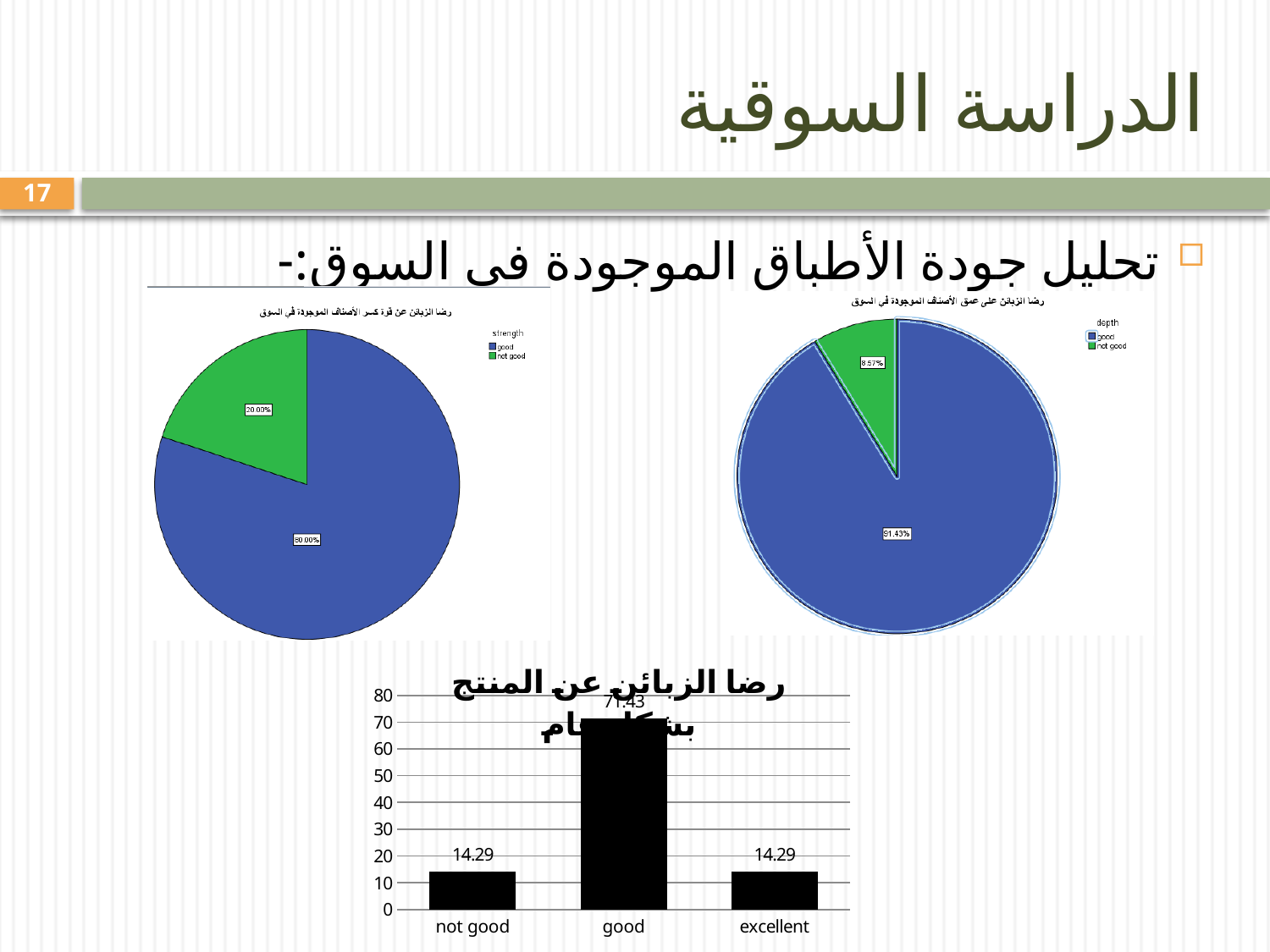
In the bottom bar chart, what is the value for "not good"? 14.29 In the top-left pie chart (legend titled "strength"), what share does the "not good" slice have? 20.00% How many entries does the legend of the top-right pie chart list? 2 In the top-left pie chart (legend titled "strength"), what share does the "good" slice have? 80.00% In the bottom bar chart, is the value for "good" greater or less than 70? greater What kind of chart is the bottom chart on the slide? bar chart In the top-right pie chart (legend titled "depth"), what share does the "good" slice have? 91.43% In the bottom bar chart, what is the value for "good"? 71.43 In the bottom bar chart, which category has the highest value? good In the bottom bar chart, what is the difference between the values for "good" and "excellent"? 57.14 In the bottom bar chart, how many categories are shown on the x axis? 3